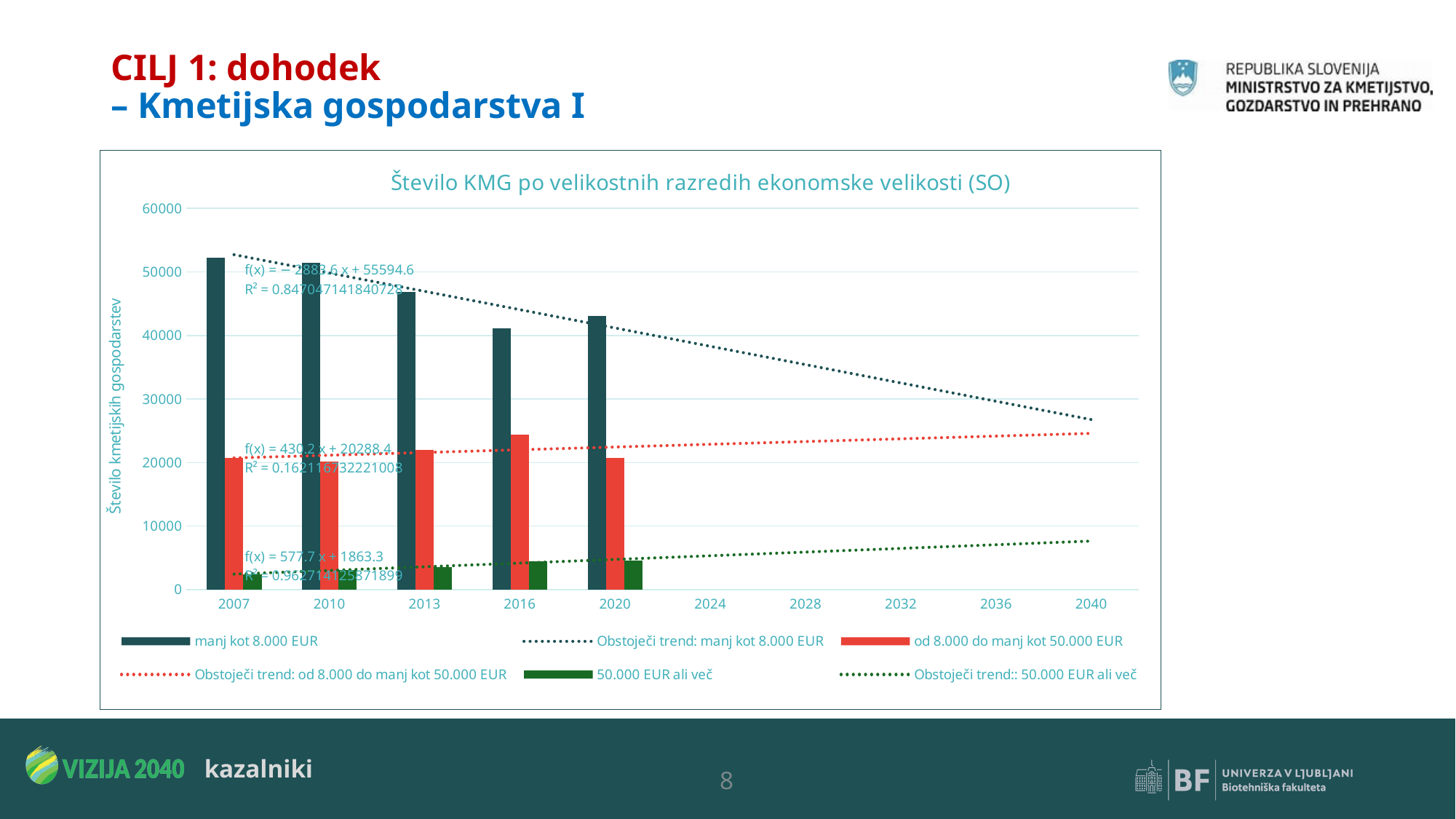
Does the dotted trend line 'Obstoječi trend: manj kot 8.000 EUR' rise or fall from 2007 to 2040? fall How many entries does the chart legend list? 6 In which year is the bar for 'manj kot 8.000 EUR' the lowest? 2016 In 2020, which is larger: the bar for 'manj kot 8.000 EUR' or the bar for '50.000 EUR ali več'? manj kot 8.000 EUR Is the value for '50.000 EUR ali več' in 2007 greater or less than 10000? less For how many years are bars plotted in the chart? 5 In which year is the bar for 'od 8.000 do manj kot 50.000 EUR' the highest? 2016 Is the value for 'manj kot 8.000 EUR' in 2007 greater or less than 50000? greater What kind of chart is shown on the slide? bar chart Is the value for 'od 8.000 do manj kot 50.000 EUR' in 2016 greater or less than 20000? greater What is the title of the chart? Število KMG po velikostnih razredih ekonomske velikosti (SO)